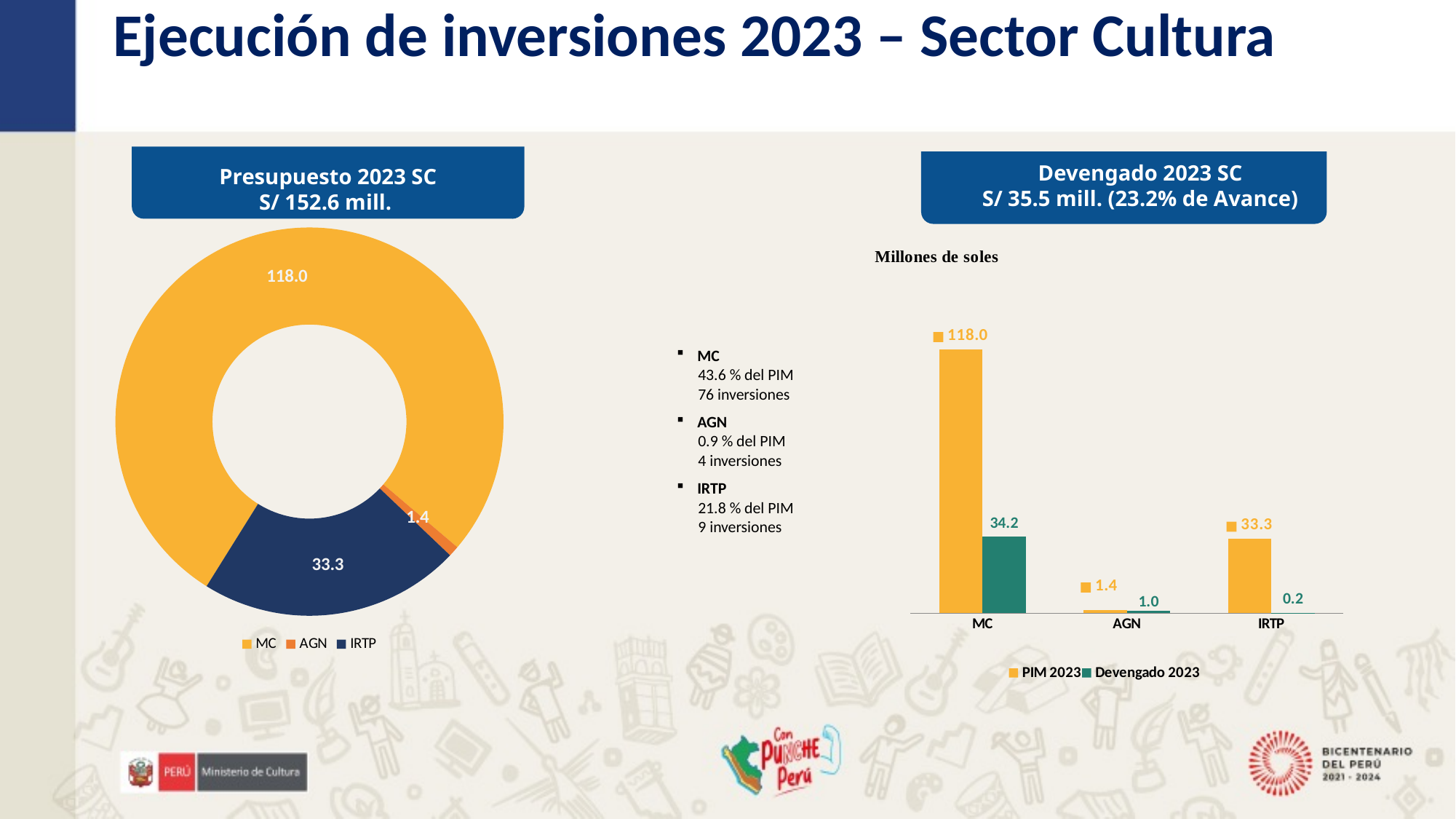
In the 'Devengado 2023 SC' bar chart, which is larger for IRTP: PIM 2023 or Devengado 2023? PIM 2023 In the 'Presupuesto 2023 SC' doughnut chart, what is the value for IRTP? 33.3 What kind of chart is the 'Presupuesto 2023 SC' chart on the left of the slide? Doughnut chart In the 'Devengado 2023 SC' bar chart, what is the difference between the PIM 2023 and Devengado 2023 values for MC? 83.8 How many series does the legend of the 'Devengado 2023 SC' bar chart list? 2 In the 'Devengado 2023 SC' bar chart, what is the PIM 2023 value for AGN? 1.4 In the 'Presupuesto 2023 SC' doughnut chart, what is the value for MC? 118.0 In the 'Devengado 2023 SC' bar chart, which category has the highest Devengado 2023 value? MC What kind of chart is the 'Devengado 2023 SC' chart on the right of the slide? Bar chart How many categories does the 'Presupuesto 2023 SC' doughnut chart show? 3 In the 'Presupuesto 2023 SC' doughnut chart, which category has the smallest value? AGN In the 'Devengado 2023 SC' bar chart, what is the Devengado 2023 value for MC? 34.2